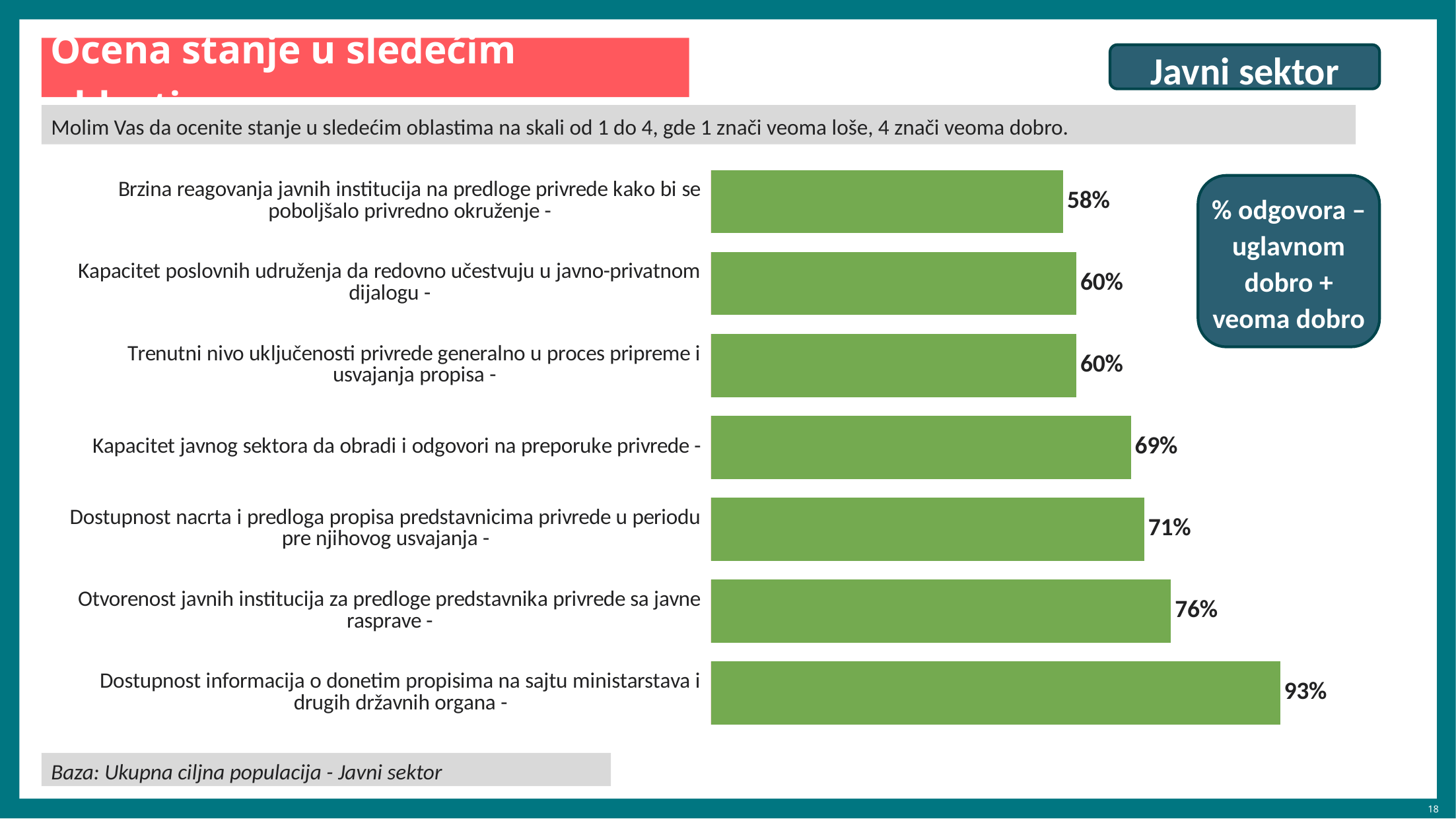
Which category has the highest value? Dostupnost informacija o donetim propisima na sajtu ministarstava i drugih državnih organa What is the value for "Dostupnost informacija o donetim propisima na sajtu ministarstava i drugih državnih organa"? 93% What is the difference between the values for "Otvorenost javnih institucija za predloge predstavnika privrede sa javne rasprave" and "Dostupnost nacrta i predloga propisa predstavnicima privrede u periodu pre njihovog usvajanja"? 5% How many categories are shown in the chart? 7 What is the value for "Kapacitet javnog sektora da obradi i odgovori na preporuke privrede"? 69% What kind of chart is shown on the slide? Bar chart Which category has the lowest value? Brzina reagovanja javnih institucija na predloge privrede kako bi se poboljšalo privredno okruženje How many categories have a value of 60%? 2 What colour are the bars in the chart? Green What is the value for "Otvorenost javnih institucija za predloge predstavnika privrede sa javne rasprave"? 76% What is the difference between the values for "Dostupnost informacija o donetim propisima na sajtu ministarstava i drugih državnih organa" and "Brzina reagovanja javnih institucija na predloge privrede kako bi se poboljšalo privredno okruženje"? 35% Which is larger: the value for "Kapacitet javnog sektora da obradi i odgovori na preporuke privrede" or for "Kapacitet poslovnih udruženja da redovno učestvuju u javno-privatnom dijalogu"? Kapacitet javnog sektora da obradi i odgovori na preporuke privrede